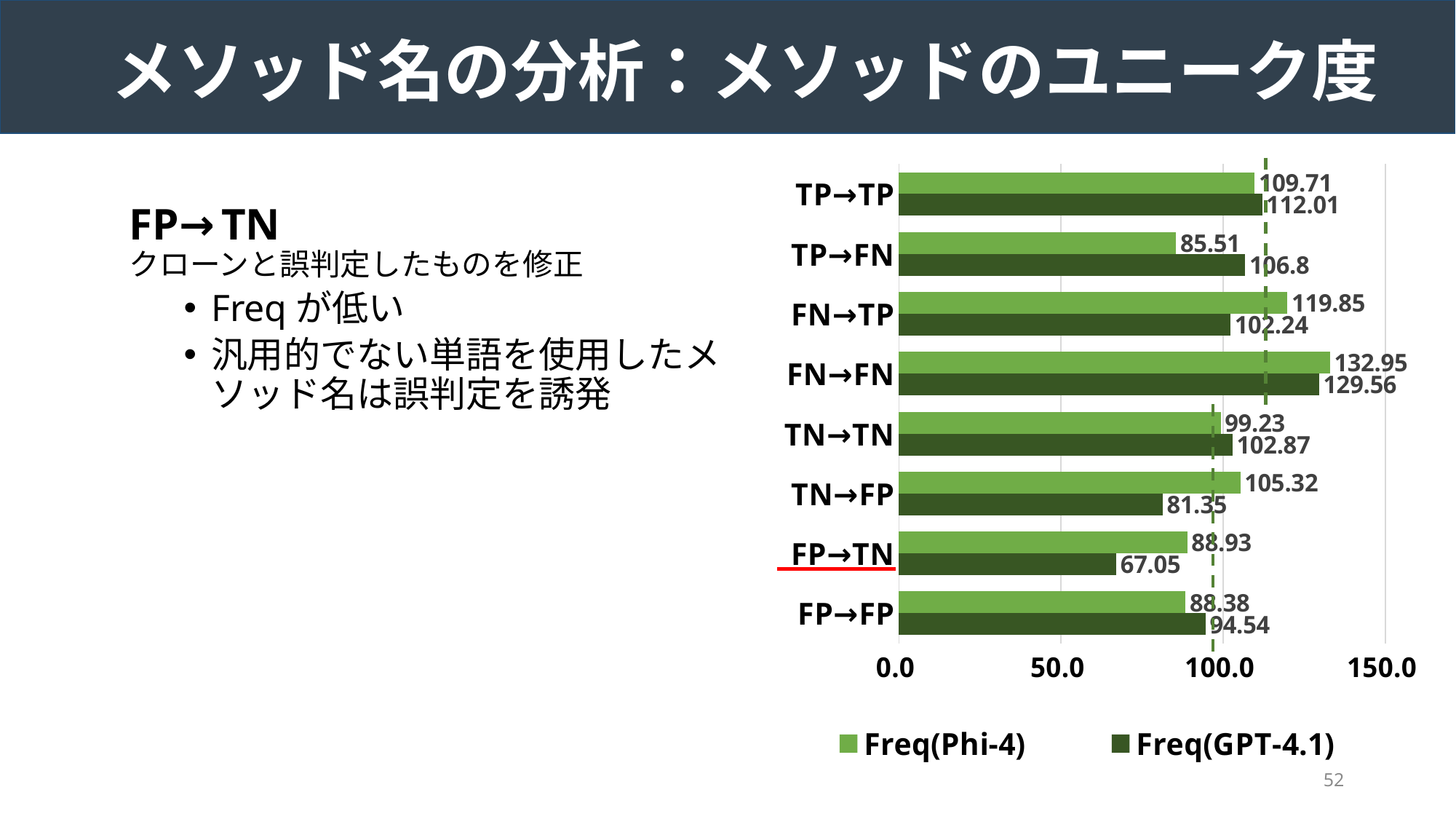
What is the Freq(GPT-4.1) value for TP→FN? 106.8 How many series does the legend list? 2 What is the difference between the Freq(Phi-4) and Freq(GPT-4.1) values for FP→TN? 21.88 What is the Freq(Phi-4) value for FP→TN? 88.93 For FN→TP, which series has the larger value, Freq(Phi-4) or Freq(GPT-4.1)? Freq(Phi-4) Which category has the lowest Freq(GPT-4.1) value? FP→TN Is the Freq(GPT-4.1) value for FN→FN greater or less than 100.0? greater How many categories are shown on the chart? 8 What is the Freq(GPT-4.1) value for TN→FP? 81.35 Which category has the highest Freq(Phi-4) value? FN→FN Which category label on the chart is underlined in red? FP→TN What kind of chart is shown on the slide? Bar chart